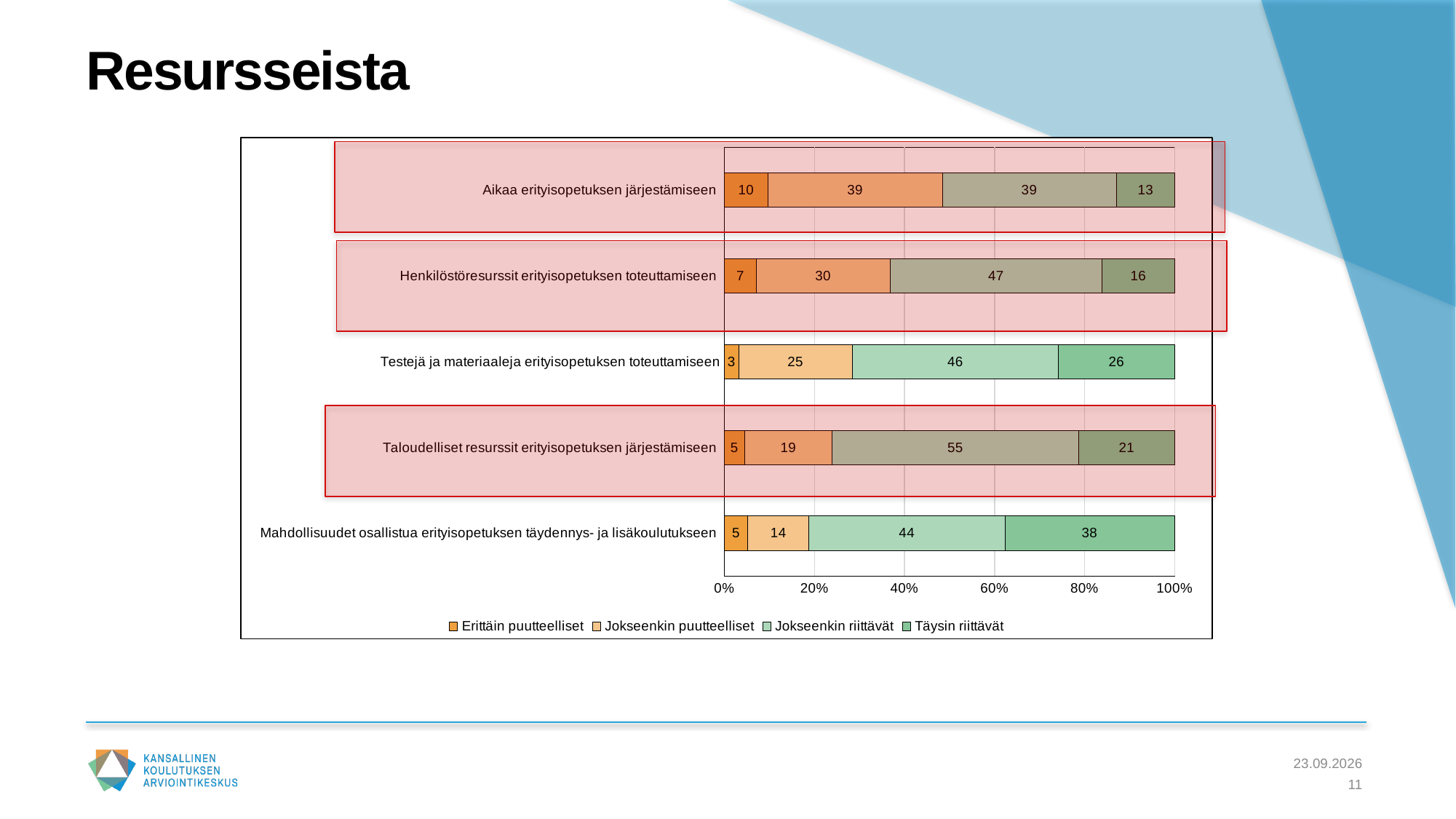
Which category has the highest value for 'Täysin riittävät'? Mahdollisuudet osallistua erityisopetuksen täydennys- ja lisäkoulutukseen What kind of chart is shown on the slide? Stacked bar chart Which category has the lowest value for 'Erittäin puutteelliset'? Testejä ja materiaaleja erityisopetuksen toteuttamiseen What is the first series listed in the legend? Erittäin puutteelliset What is the value of 'Erittäin puutteelliset' for 'Aikaa erityisopetuksen järjestämiseen'? 10 What is the value of 'Täysin riittävät' for 'Henkilöstöresurssit erityisopetuksen toteuttamiseen'? 16 How many series does the legend list? 4 What is the value of 'Jokseenkin riittävät' for 'Taloudelliset resurssit erityisopetuksen järjestämiseen'? 55 What is the total of the stacked bar for 'Henkilöstöresurssit erityisopetuksen toteuttamiseen'? 100 How many categories (resource types) are plotted in the chart? 5 What is the difference between the 'Jokseenkin puutteelliset' values for 'Aikaa erityisopetuksen järjestämiseen' and 'Henkilöstöresurssit erityisopetuksen toteuttamiseen'? 9 Which is larger: the 'Täysin riittävät' value for 'Testejä ja materiaaleja erityisopetuksen toteuttamiseen' or for 'Taloudelliset resurssit erityisopetuksen järjestämiseen'? Testejä ja materiaaleja erityisopetuksen toteuttamiseen